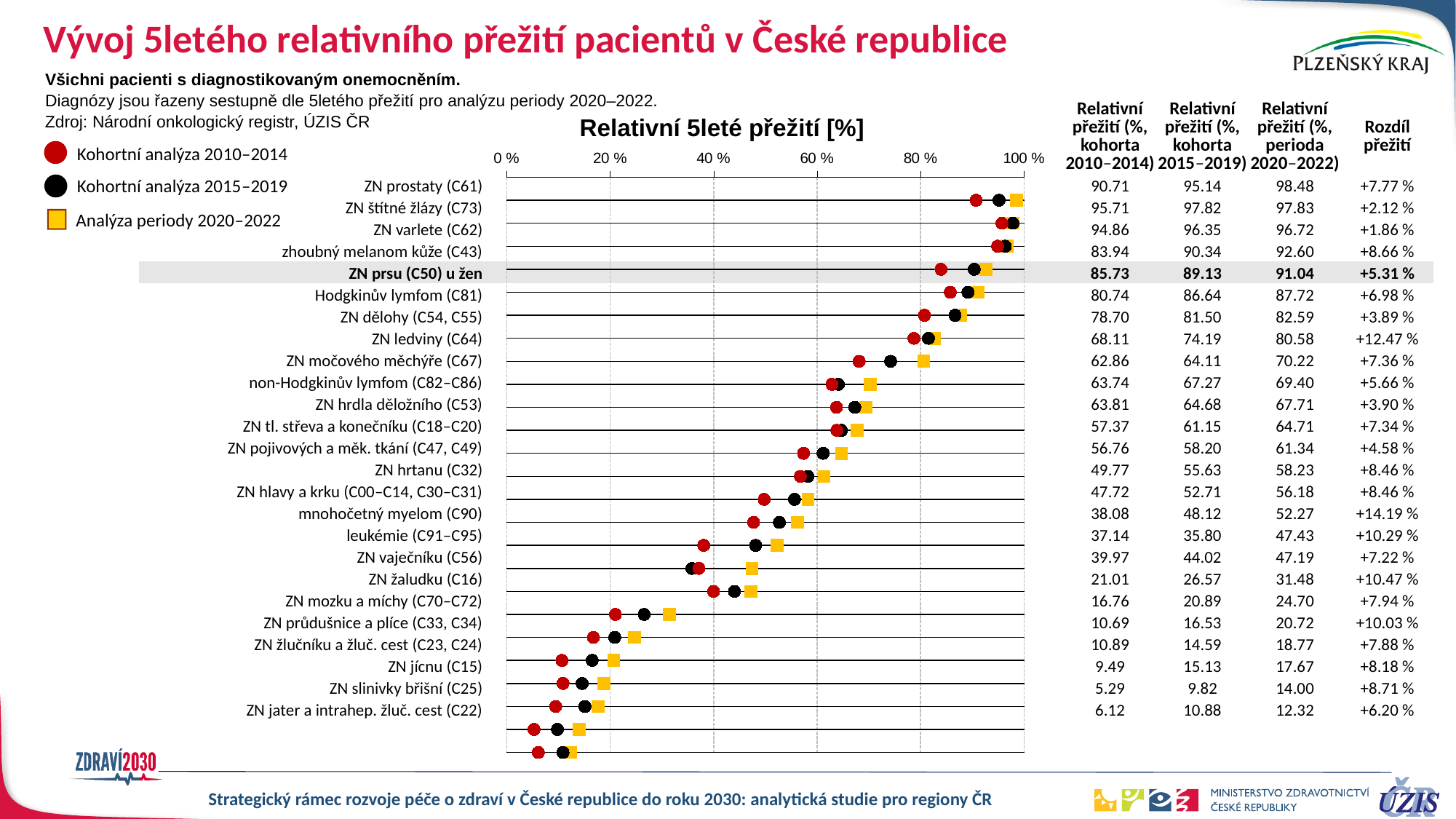
What is the relative 5-year survival for ZN prostaty (C61) in the period analysis 2020–2022? 98.48 Is the period 2020–2022 value for ZN žaludku (C16) greater or less than 40 %? less How many diagnoses are listed on the chart? 25 Which diagnosis shows the largest 'Rozdíl přežití' value? mnohočetný myelom (C90) Which diagnosis has the lowest relative 5-year survival in the period analysis 2020–2022? ZN jater a intrahep. žluč. cest (C22) Which diagnosis has the highest relative 5-year survival in the period analysis 2020–2022? ZN prostaty (C61) What marker shape and colour represents 'Analýza periody 2020–2022' in the legend? yellow square How many series does the legend list? 3 For leukémie (C91–C95), which is larger: the cohort 2010–2014 value or the cohort 2015–2019 value? cohort 2010–2014 What is the 'Rozdíl přežití' value for ZN ledviny (C64)? +12.47 % What is the relative 5-year survival for ZN slinivky břišní (C25) in the cohort analysis 2015–2019? 9.82 What is the relative 5-year survival for ZN ledviny (C64) in the cohort analysis 2010–2014? 68.11